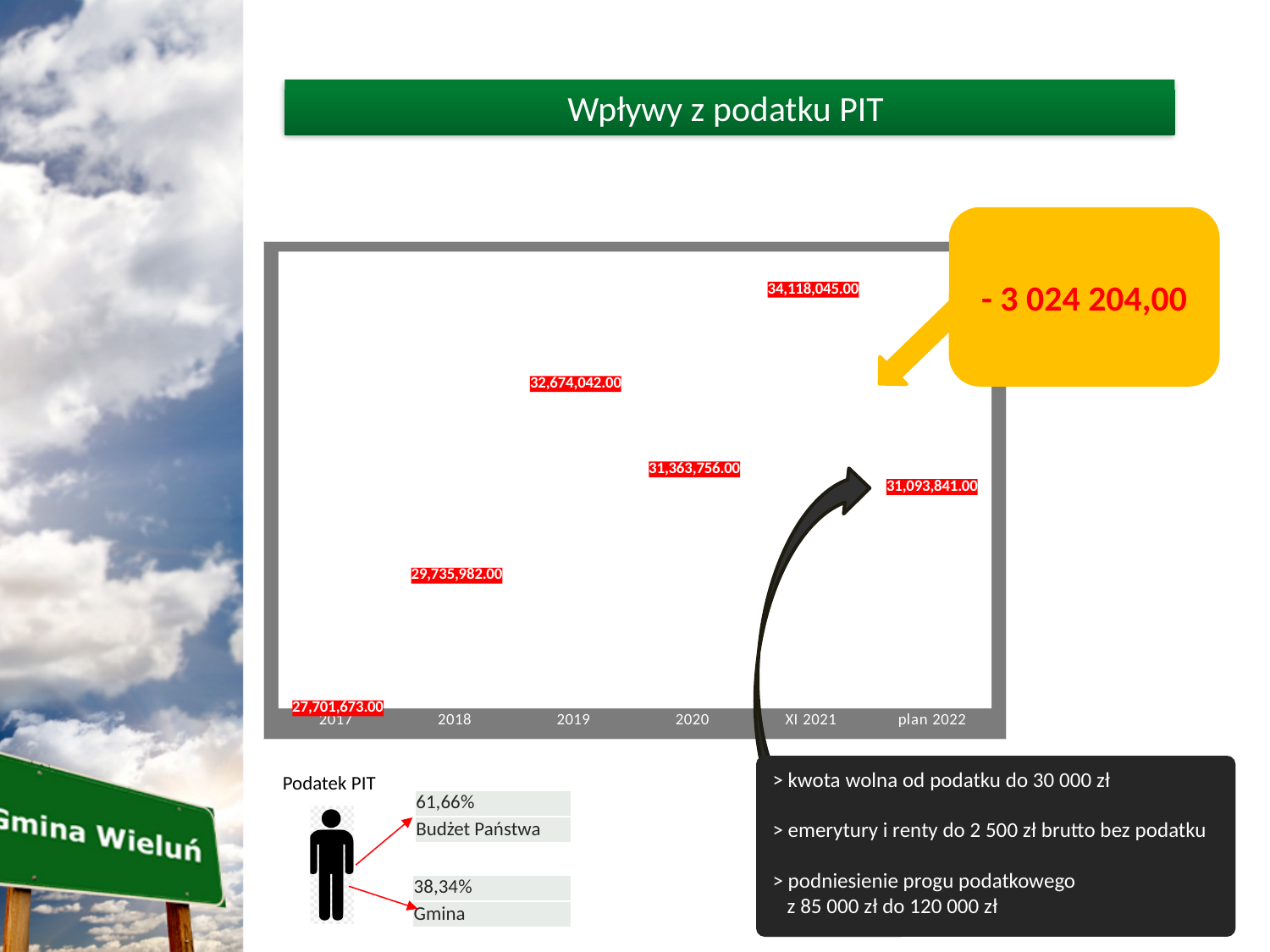
What is the difference between the values for 2018 and 2017? 2,034,309.00 Which category has the highest value on the chart? XI 2021 What is the value shown for plan 2022 on the chart? 31,093,841.00 Which is larger, the value for 2019 or the value for 2020? 2019 What is the difference between the values for XI 2021 and plan 2022? 3,024,204.00 What is the value shown for 2017 on the chart? 27,701,673.00 What is the title shown above the chart? Wpływy z podatku PIT Which category has the lowest value on the chart? 2017 What is the value shown for XI 2021 on the chart? 34,118,045.00 Do the values rise or fall from 2017 to 2019? rise What is the value shown for 2019 on the chart? 32,674,042.00 How many categories are shown on the x axis of the chart? 6